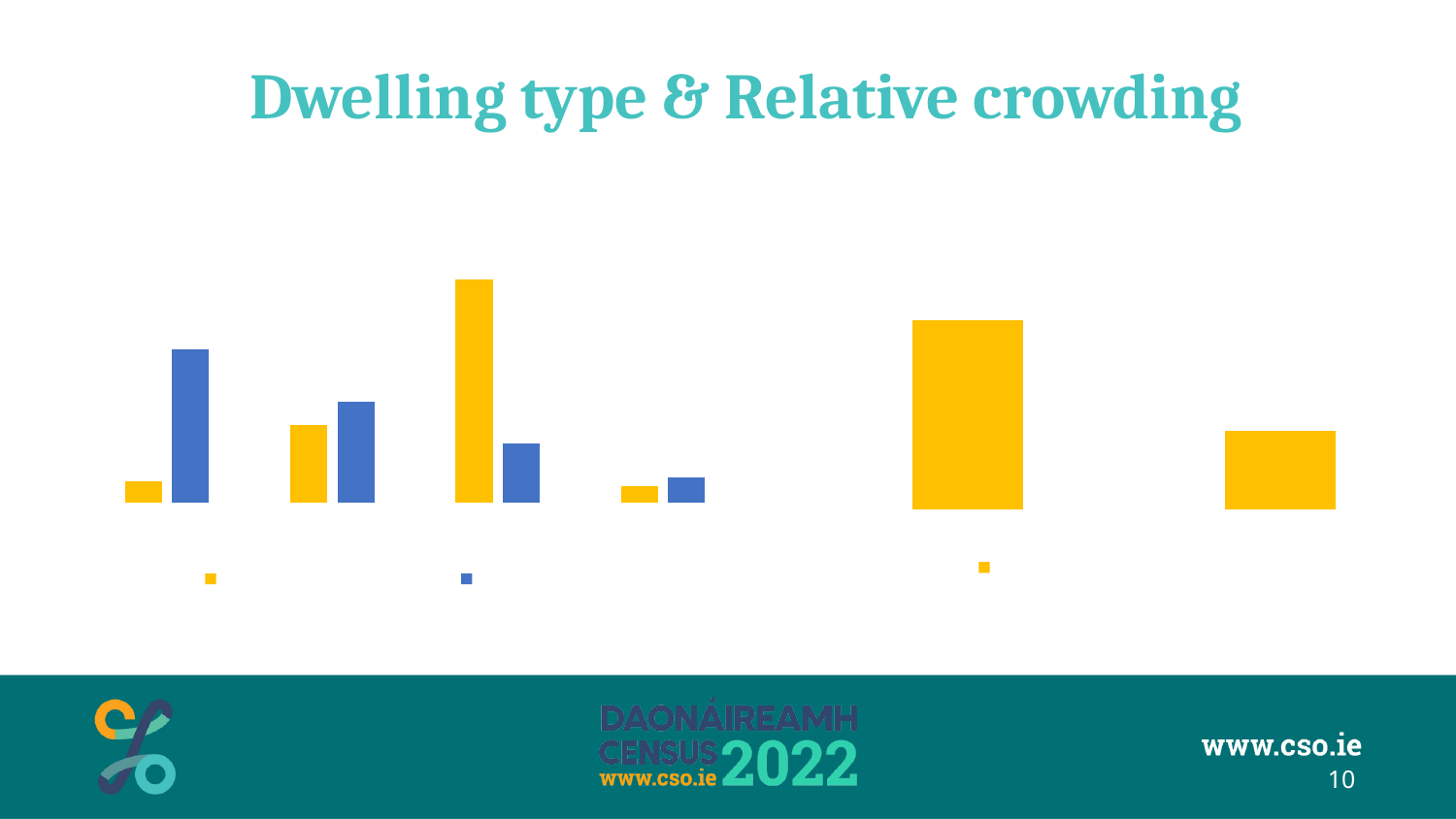
What two colours are used for the bars in the left chart? yellow and blue How many series does the legend of the right chart list? 1 How many series does the legend of the left chart list? 2 What is the title of the slide containing the charts? Dwelling type & Relative crowding How many groups of bars are plotted in the left chart? 4 What kind of chart is the chart on the right of the slide? bar chart In the right chart, is the left bar or the right bar taller? the left bar How many bars are plotted in the right chart? 2 What kind of chart is the chart on the left of the slide? bar chart In the left chart, which group of bars contains the tallest bar: the first, second, third or fourth from the left? the third